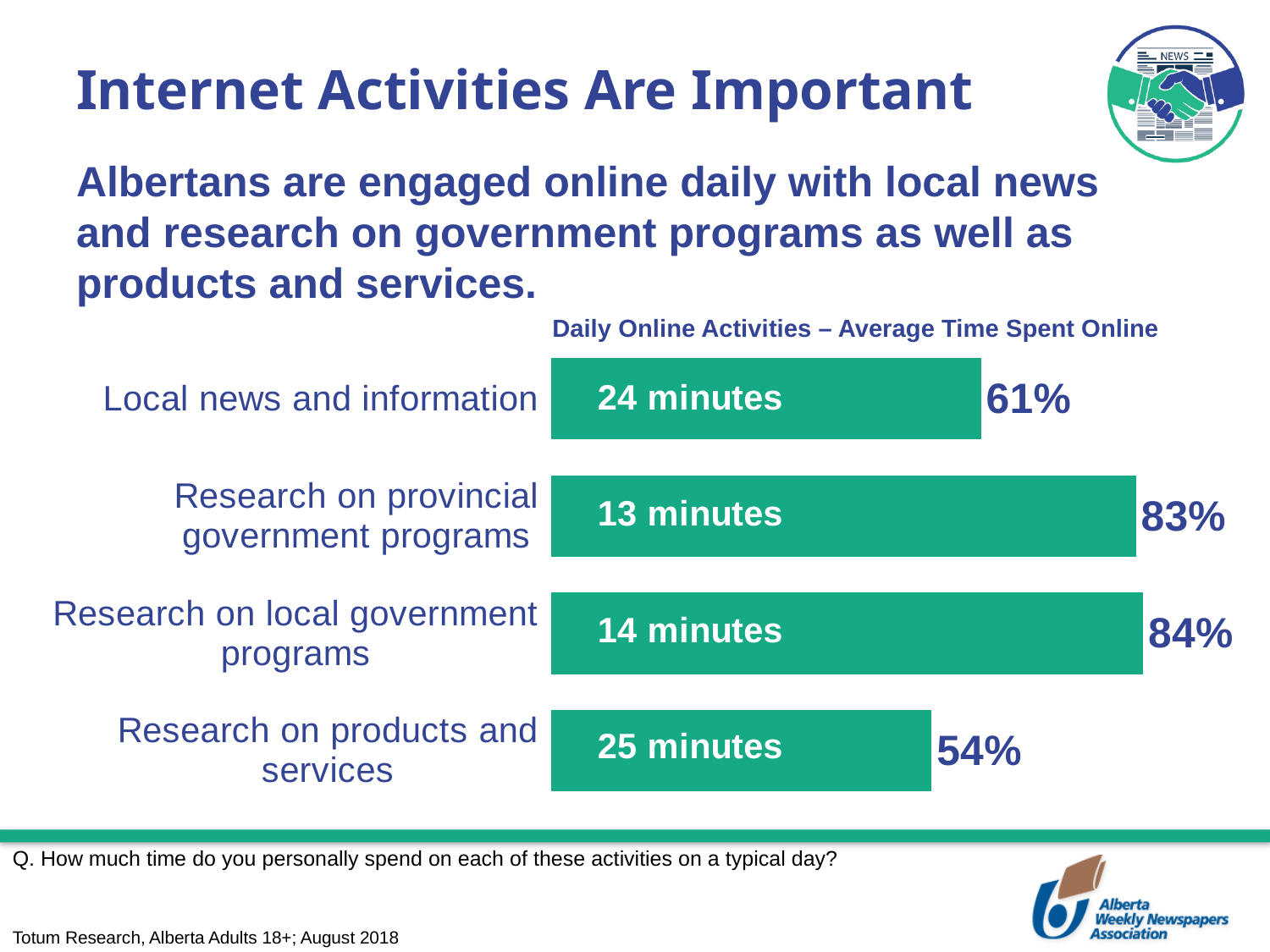
Which has a higher percentage, Local news and information or Research on products and services? Local news and information What is the title of the chart? Daily Online Activities – Average Time Spent Online Which activity has the highest average time spent online? Research on products and services How many activities are shown in the chart? 4 What percentage is shown for Research on local government programs? 84% Which activity has the lowest percentage? Research on products and services What is the difference in average minutes between Research on products and services and Research on provincial government programs? 12 minutes What percentage is shown for Local news and information? 61% What is the average time spent online on Research on products and services? 25 minutes What is the average time spent on Research on provincial government programs? 13 minutes What is the difference in percentage between Research on provincial government programs and Local news and information? 22% What kind of chart is shown on the slide? Bar chart